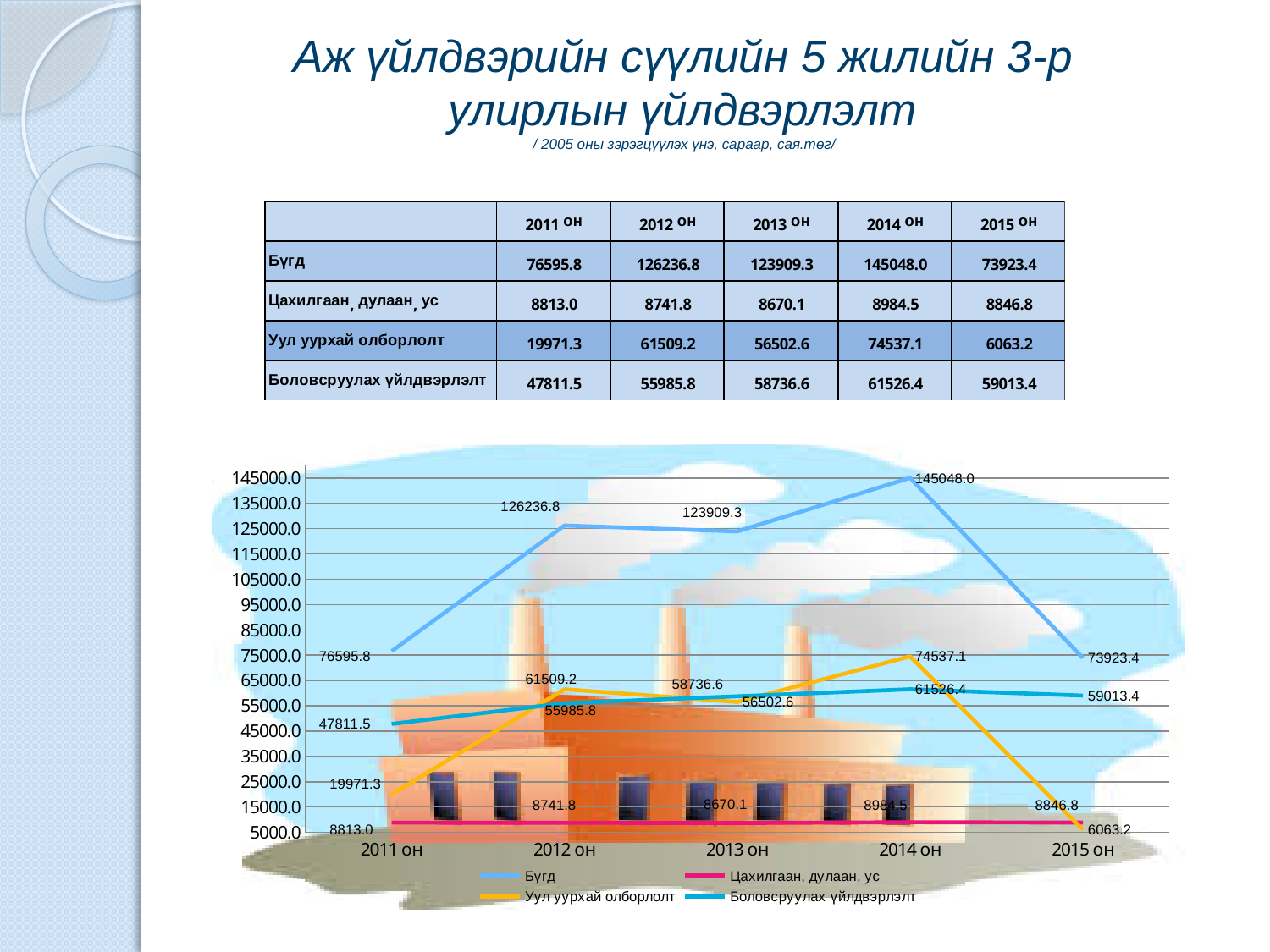
What is the value of the Бүгд series for 2014 он? 145048.0 Does the Уул уурхай олборлолт series rise or fall from 2014 он to 2015 он? fall What type of chart is shown on the slide? line chart How many series does the chart legend list? 4 Which is larger in 2013 он: Боловсруулах үйлдвэрлэлт or Уул уурхай олборлолт? Боловсруулах үйлдвэрлэлт What is the value of the Уул уурхай олборлолт series for 2015 он? 6063.2 How many years are plotted along the x axis of the chart? 5 Which series is drawn in pink/magenta in the chart? Цахилгаан, дулаан, ус In which year is the Бүгд series highest? 2014 он What is the difference between the Бүгд values for 2014 он and 2015 он? 71124.6 What is the value of the Боловсруулах үйлдвэрлэлт series for 2011 он? 47811.5 In which year is the Уул уурхай олборлолт series lowest? 2015 он